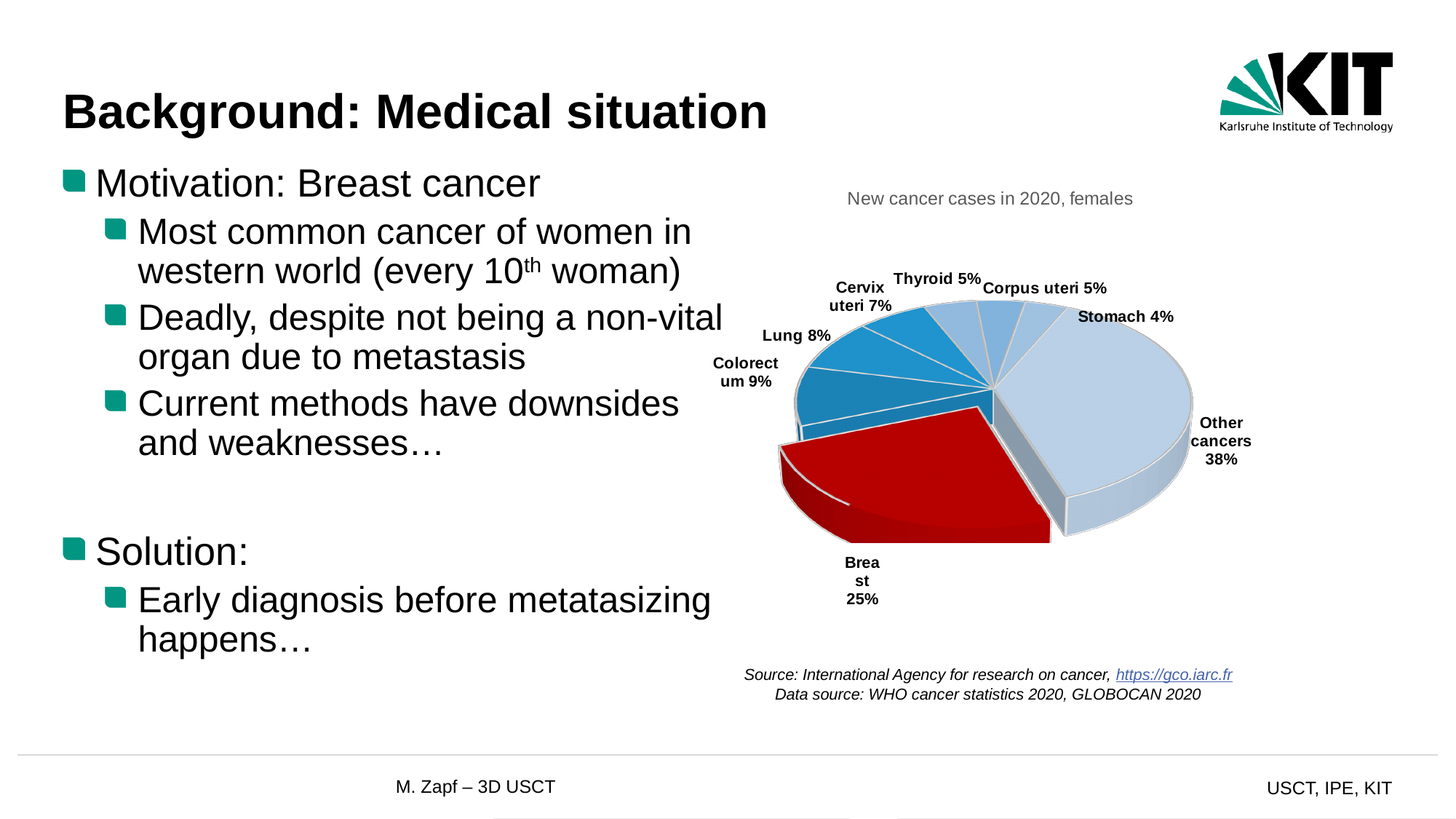
Which slice of the pie is the largest? Other cancers What share of new cancer cases in 2020 among females is breast cancer? 25% How many slices does the pie chart have? 8 What percentage is shown for colorectum cancer? 9% Which slice is coloured red and pulled out from the pie? Breast What is the title of the chart? New cancer cases in 2020, females Which named cancer type has the smallest share? Stomach What kind of chart is shown on the slide? pie chart What is the difference in percentage points between breast cancer and lung cancer? 17 Which has a larger share, cervix uteri or corpus uteri? Cervix uteri What percentage is shown for lung cancer? 8% What percentage is shown for stomach cancer? 4%